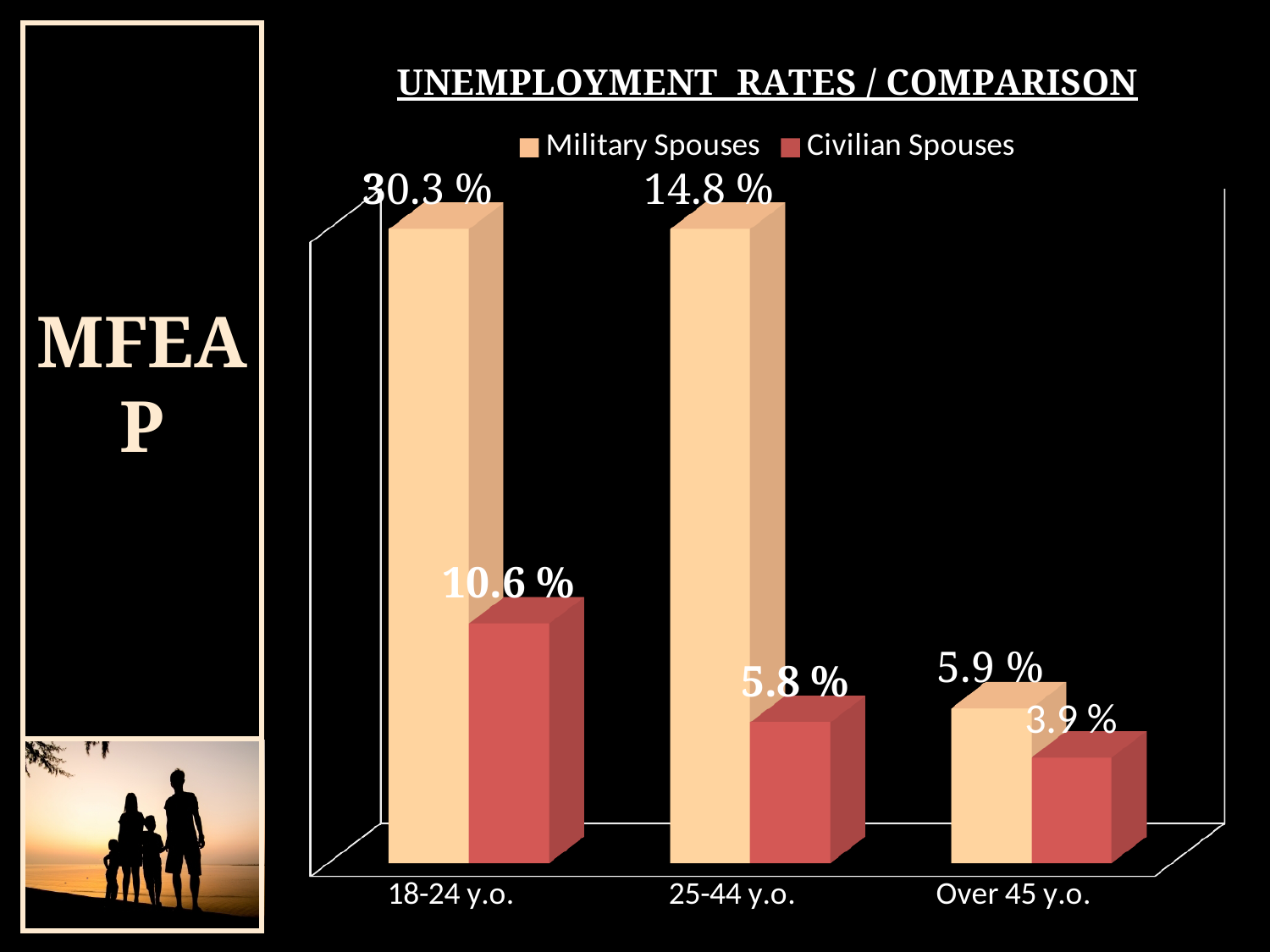
Do the Civilian Spouses unemployment rates rise or fall from the 18-24 y.o. group to the Over 45 y.o. group? Fall Which is larger for the 25-44 y.o. group: the Military Spouses rate or the Civilian Spouses rate? Military Spouses What is the unemployment rate for Military Spouses aged 18-24 y.o.? 30.3 % Which age group has the highest unemployment rate for Military Spouses? 18-24 y.o. How many age groups are shown on the x axis? 3 How many series does the legend list? 2 What is the unemployment rate for Civilian Spouses aged 25-44 y.o.? 5.8 % Which age group has the lowest unemployment rate for Civilian Spouses? Over 45 y.o. What is the difference between the Military Spouses and Civilian Spouses unemployment rates for the 18-24 y.o. group? 19.7 % What is the unemployment rate for Civilian Spouses in the Over 45 y.o. group? 3.9 % What is the unemployment rate for Military Spouses in the Over 45 y.o. group? 5.9 % What kind of chart is shown on the slide? Bar chart